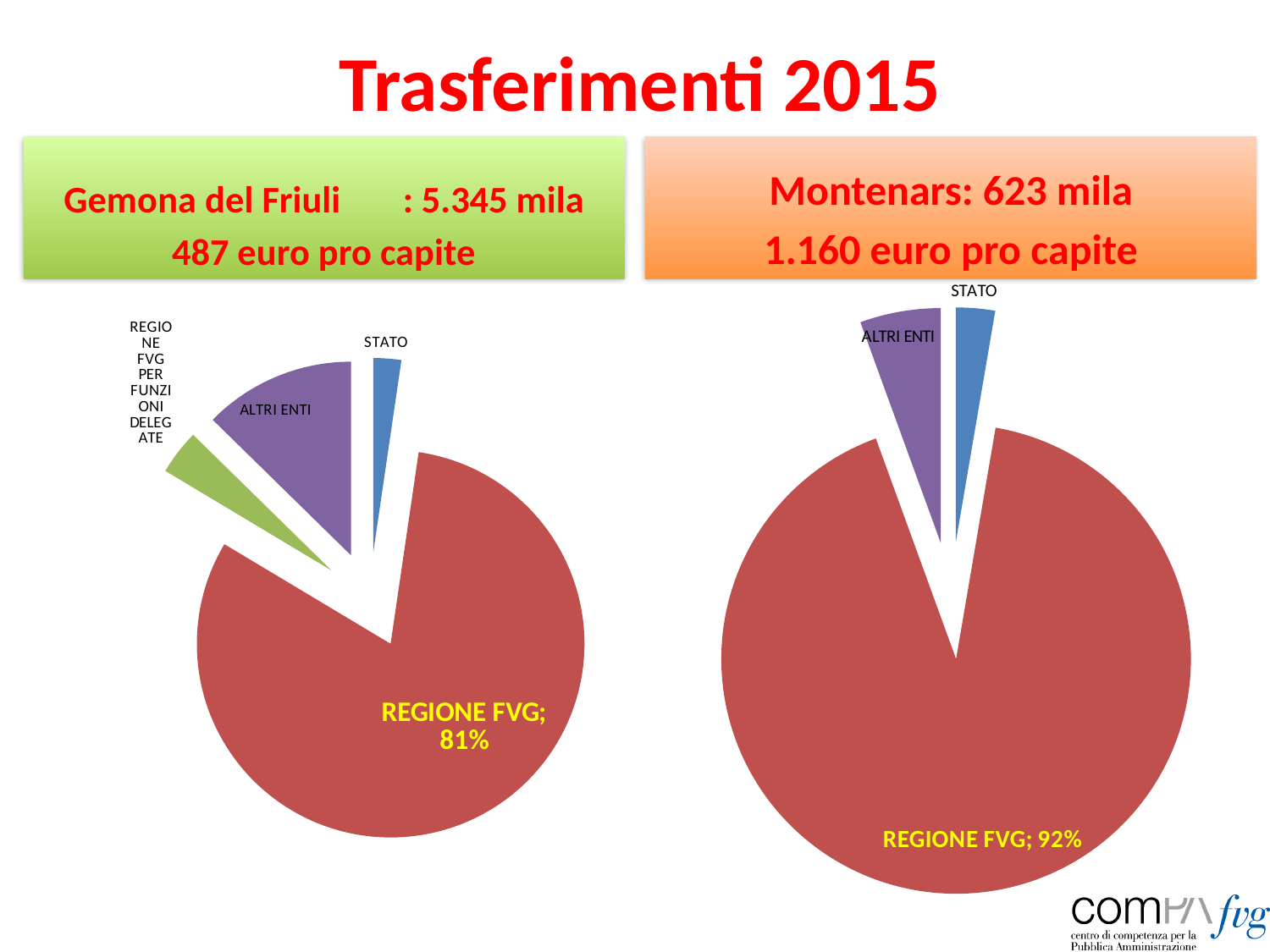
In the Gemona del Friuli pie chart on the left, which slice is the largest? REGIONE FVG In the Montenars pie chart on the right, what colour is the REGIONE FVG slice? Red By how many percentage points does the REGIONE FVG share in the Montenars chart on the right exceed the REGIONE FVG share in the Gemona del Friuli chart on the left? 11 percentage points Which chart shows a larger share for REGIONE FVG: the Gemona del Friuli chart on the left or the Montenars chart on the right? Montenars In the Gemona del Friuli pie chart on the left, what share is labelled for REGIONE FVG? 81% What kind of chart is used for Gemona del Friuli on the left of the slide? Pie chart In the Montenars pie chart on the right, what share is labelled for REGIONE FVG? 92% How many slices does the Gemona del Friuli pie chart on the left have? 4 In the Gemona del Friuli pie chart on the left, which slice is the smallest? STATO In the Gemona del Friuli pie chart on the left, which slice is larger: ALTRI ENTI or STATO? ALTRI ENTI How many slices does the Montenars pie chart on the right have? 3 In the Montenars pie chart on the right, which slice is the smallest? STATO